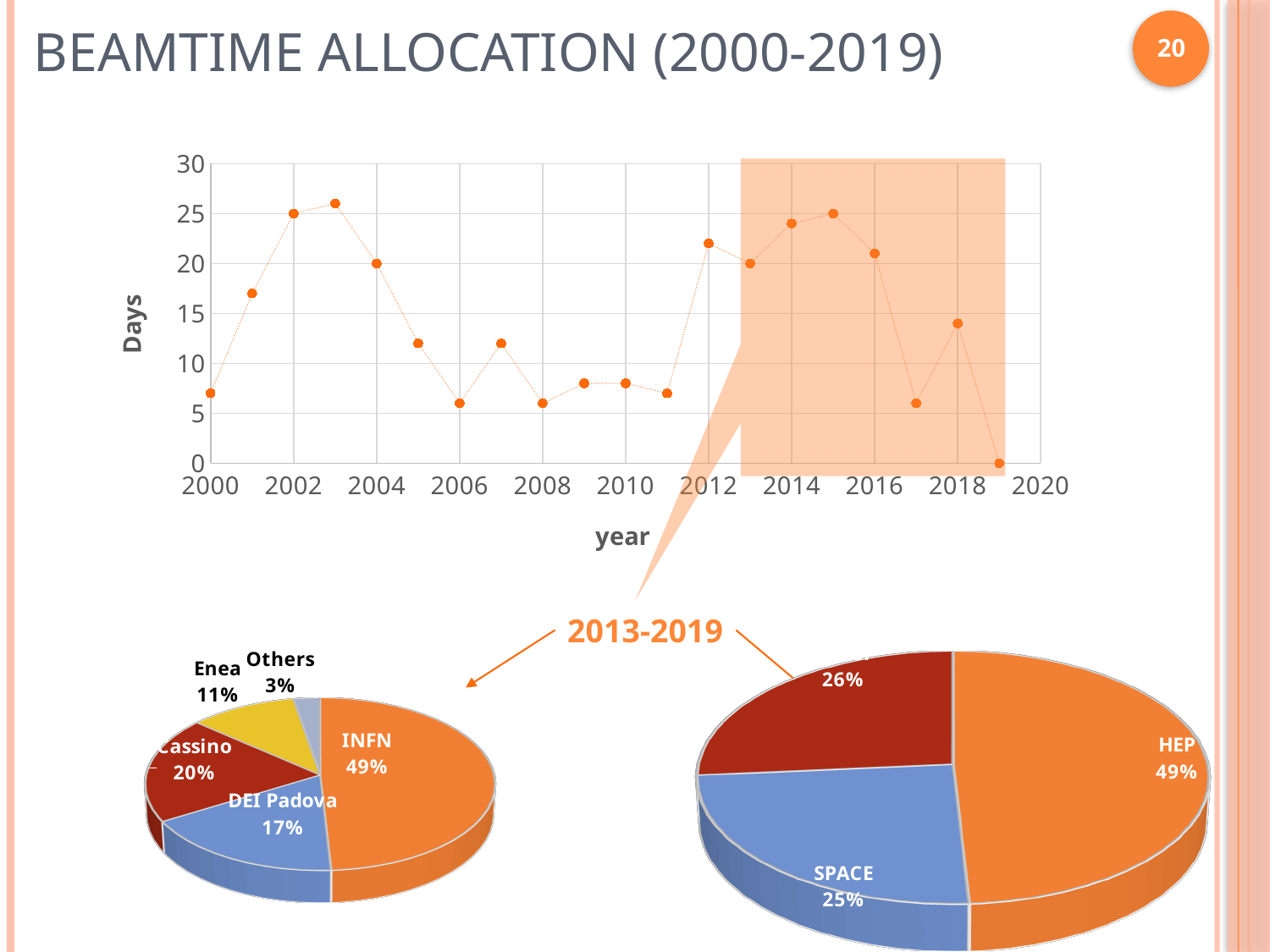
In the top line chart, is the value for 2017 greater or less than 10? less In the top line chart, is the value for 2001 greater or less than 15? greater In the bottom-right pie chart, which category has the largest share? HEP In the top line chart, is the value for 2012 greater or less than 20? greater In the bottom-left pie chart, which category has the smallest share? Others In the top line chart, how many data points are plotted? 20 In the bottom-left pie chart, what is the difference between the INFN share and the DEI Padova share? 32% In the bottom-left pie chart, what share does INFN have? 49% In the bottom-right pie chart, what share does SPACE have? 25% What type of chart is the top chart showing Days by year? line chart In the top line chart, which year has the lowest number of days? 2019 In the top line chart, do the values rise or fall from 2015 to 2019? fall